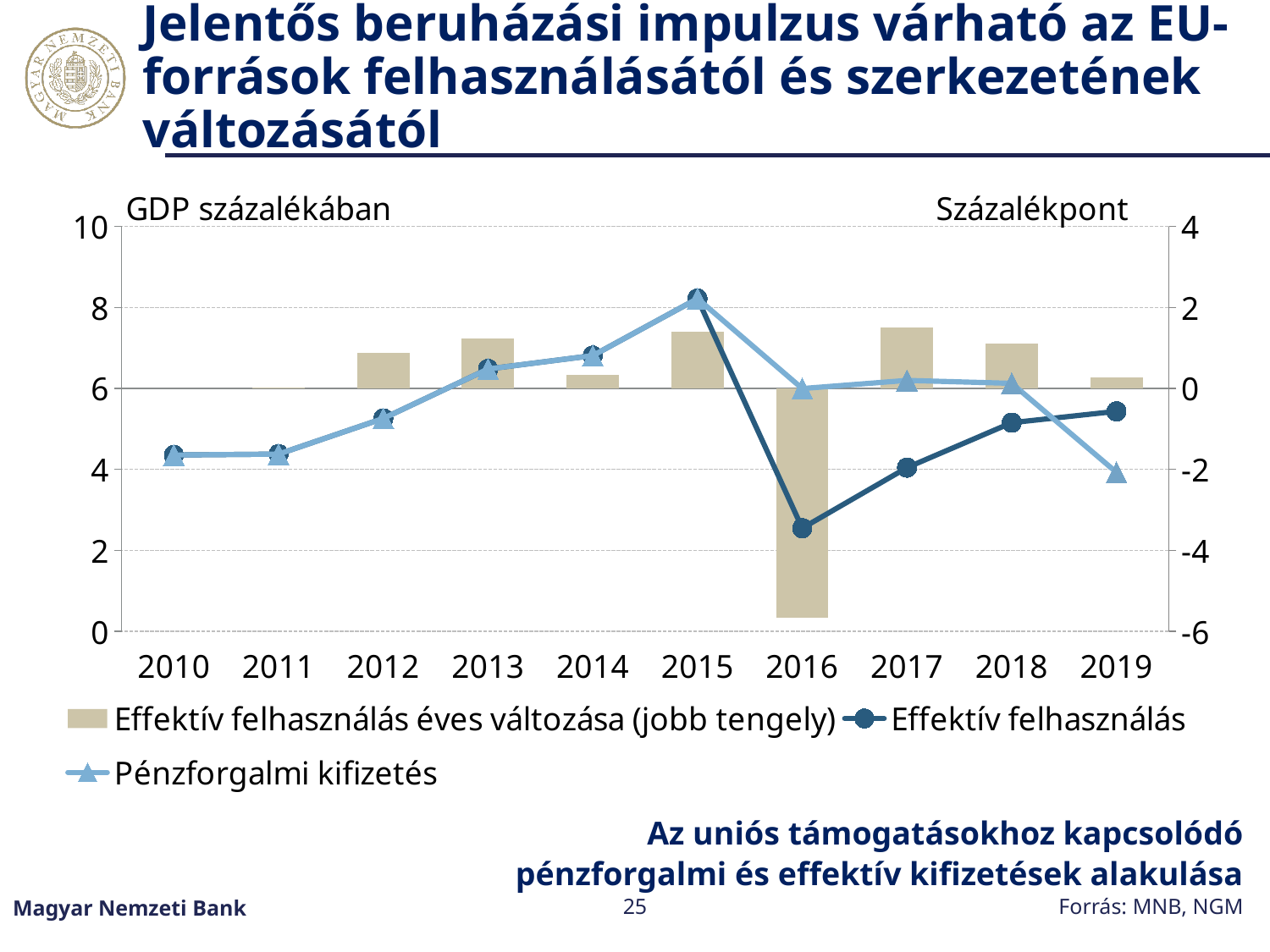
In which year is the Pénzforgalmi kifizetés line at its lowest? 2019 In which year is the bar for Effektív felhasználás éves változása (jobb tengely) the lowest? 2016 How many years are shown on the x axis of the chart? 10 In 2016, which is larger: Effektív felhasználás or Pénzforgalmi kifizetés? Pénzforgalmi kifizetés Is the bar for Effektív felhasználás éves változása in 2016 greater or less than -4 on the right axis? less Is the value of Effektív felhasználás in 2016 greater or less than 4 on the left axis? less What is the label of the left axis of the chart? GDP százalékában In which year does the Effektív felhasználás line reach its lowest value? 2016 In which year does the Effektív felhasználás line reach its highest value? 2015 How many series does the chart legend list? 3 What kind of chart is shown on the slide? A combined bar and line chart Does the Effektív felhasználás line rise or fall from 2016 to 2019? rise